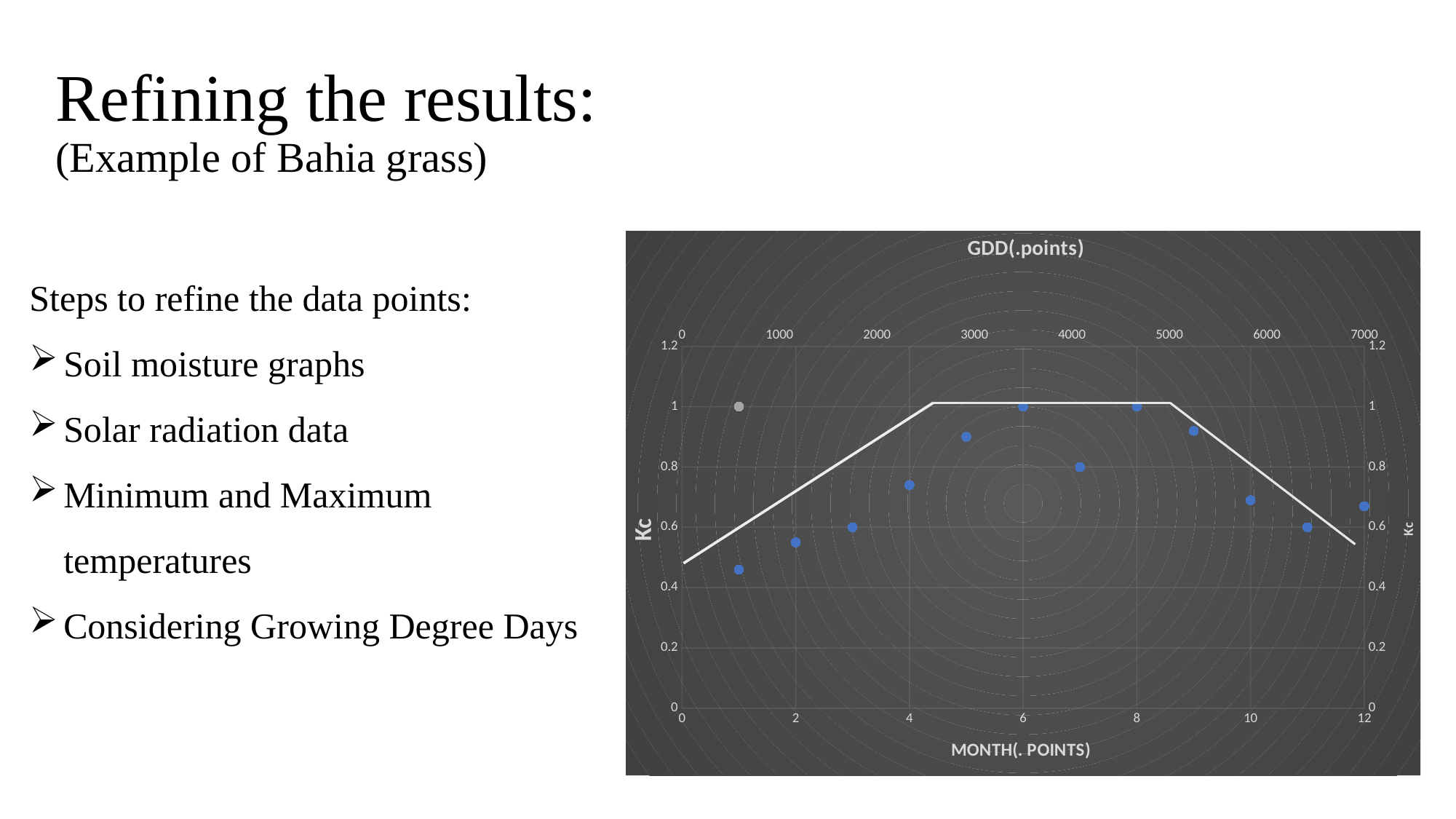
Is the Kc value of the blue point at month 4 greater or less than 0.6? greater What is the title of the vertical axis of the chart? Kc Do the Kc values of the blue points rise or fall from month 1 to month 6? rise What is the Kc value of the blue point at month 7? 0.8 Which blue point has the lowest Kc value, month 1 or month 5? month 1 How many blue data points are plotted on the chart? 12 What is the Kc value of the blue point at month 6? 1 Is the Kc value of the blue point at month 1 greater or less than 0.6? less What kind of chart is shown on the slide? scatter chart Is the Kc value of the blue point at month 5 greater or less than 0.8? greater What is the title of the bottom horizontal axis of the chart? MONTH(. POINTS) What is the Kc value of the blue point at month 8? 1